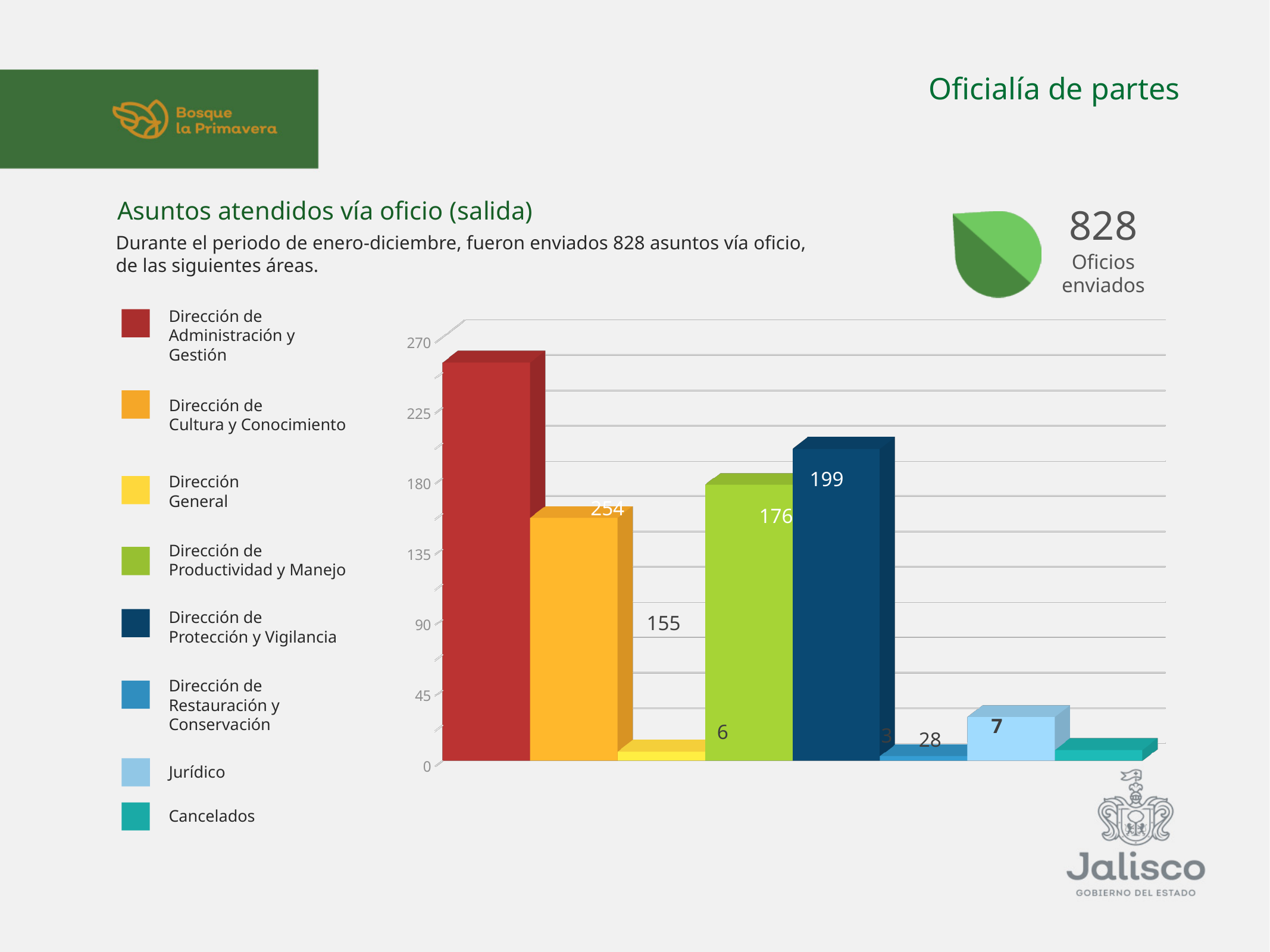
Which area has the highest value in the chart? Dirección de Administración y Gestión What is the value for Dirección de Administración y Gestión? 254 What kind of chart is shown on the slide? bar chart What is the value for Dirección de Productividad y Manejo? 176 Is the value for Dirección de Administración y Gestión greater or less than 225? greater What is the value for Dirección de Cultura y Conocimiento? 155 Is the value for Dirección de Cultura y Conocimiento greater or less than 180? less How many bars does the chart show? 8 What is the difference between the values for Dirección de Protección y Vigilancia and Dirección de Productividad y Manejo? 23 What is the value for Dirección de Protección y Vigilancia? 199 Which is larger, the value for Dirección de Protección y Vigilancia or for Dirección de Productividad y Manejo? Dirección de Protección y Vigilancia How many entries does the legend list? 8